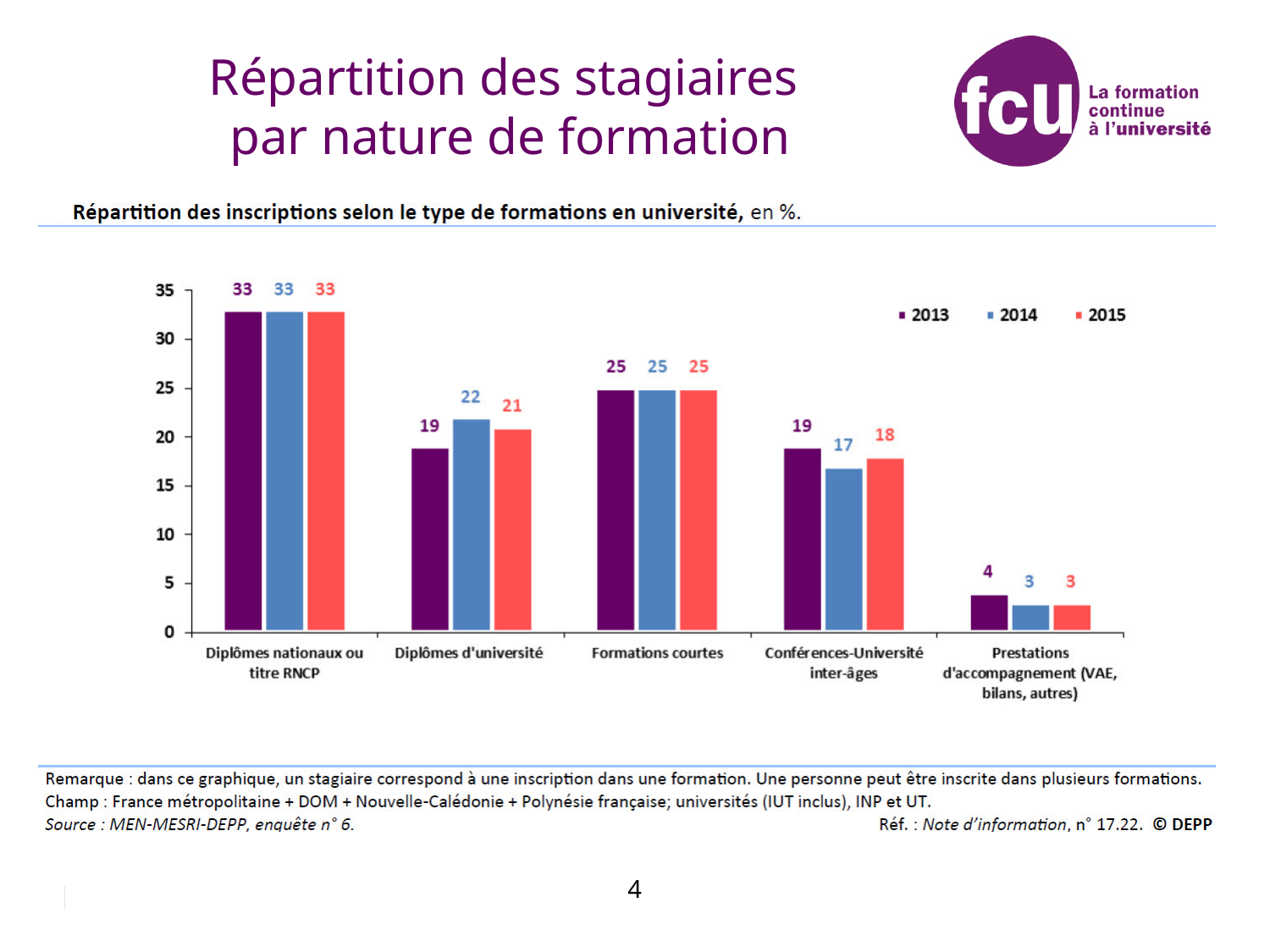
What is the value for Prestations d'accompagnement (VAE, bilans, autres) in 2013? 4 What is the value for Conférences-Université inter-âges in 2015? 18 How many categories are shown on the x axis? 5 Which category has the highest value in 2015? Diplômes nationaux ou titre RNCP Which category has the lowest value in 2013? Prestations d'accompagnement (VAE, bilans, autres) Which years are listed in the legend? 2013, 2014, 2015 What kind of chart is shown? Bar chart What is the value for Diplômes d'université in 2014? 22 What is the difference between the 2014 value for Diplômes d'université and the 2014 value for Conférences-Université inter-âges? 5 Which is larger: the 2013 value for Diplômes d'université or the 2013 value for Formations courtes? Formations courtes How many series does the legend list? 3 What is the difference between the 2013 and 2015 values for Diplômes d'université? 2